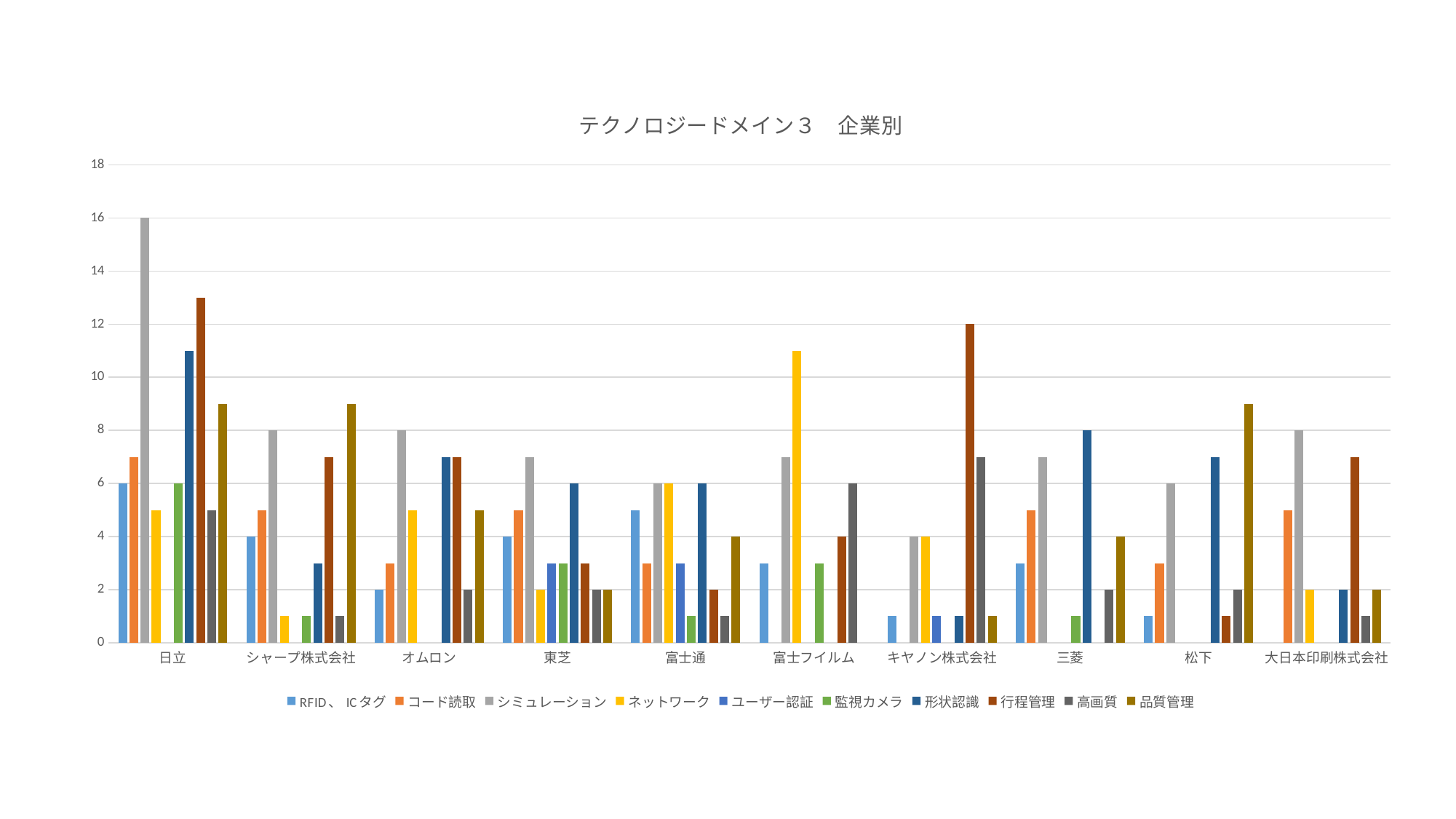
Is the value of 行程管理 for 日立 greater or less than 12? greater What is the title of the chart? テクノロジードメイン３ 企業別 What is the difference between シミュレーション for 日立 and 行程管理 for キヤノン株式会社? 4 What is the value of シミュレーション for 日立? 16 Is the value of ネットワーク for 富士フイルム greater or less than 10? greater Which company has the tallest bar in the whole chart? 日立 What type of chart is shown on the slide? bar chart How many series does the legend list? 10 What is the value of 行程管理 for キヤノン株式会社? 12 How many companies (categories) are shown on the x axis? 10 What is the value of 形状認識 for 三菱? 8 What is the value of シミュレーション for 大日本印刷株式会社? 8